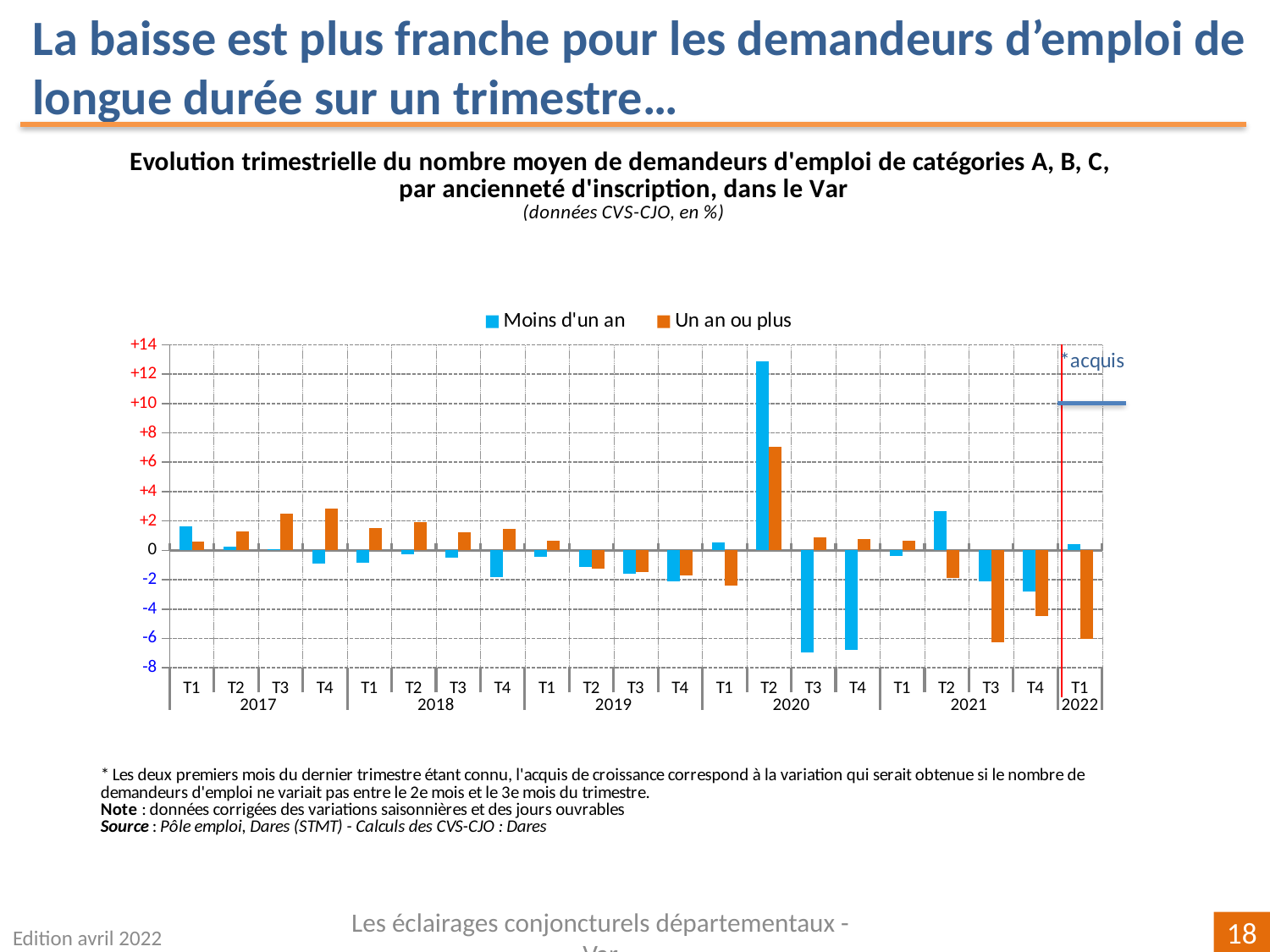
How many series does the legend list? 2 Is the value for 'Un an ou plus' in T1 2022 greater or less than -4? less How many quarters are plotted along the x axis? 21 What kind of chart is shown on the slide? bar chart Is the value for 'Moins d'un an' in T3 2020 greater or less than -6? less In which quarter is the value for 'Moins d'un an' highest? T2 2020 Is the value for 'Moins d'un an' in T2 2020 greater or less than +12? greater In T2 2020, which series has the larger value, 'Moins d'un an' or 'Un an ou plus'? Moins d'un an In which quarter is the value for 'Un an ou plus' highest? T2 2020 What are the two series named in the legend? Moins d'un an; Un an ou plus In T3 2021, which series has the larger value, 'Moins d'un an' or 'Un an ou plus'? Moins d'un an